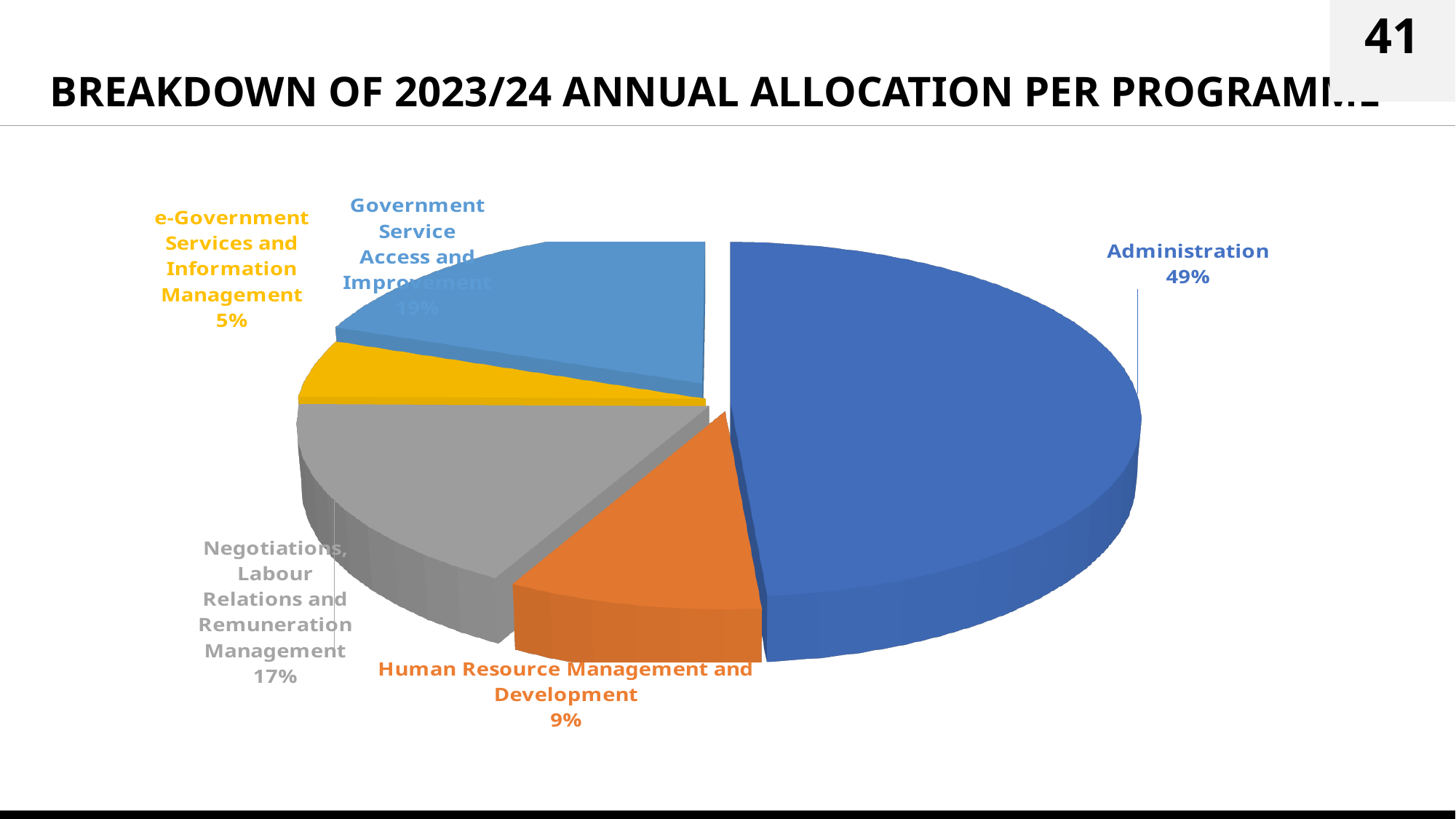
How many programmes are shown in the pie chart? 5 What is the title of the chart on this slide? Breakdown of 2023/24 Annual Allocation per Programme Which has a larger share: Negotiations, Labour Relations and Remuneration Management or Human Resource Management and Development? Negotiations, Labour Relations and Remuneration Management What percentage is shown for e-Government Services and Information Management? 5% What percentage is shown for Human Resource Management and Development? 9% What type of chart is used on this slide? Pie chart What share of the 2023/24 annual allocation goes to Administration? 49% What percentage is shown for Negotiations, Labour Relations and Remuneration Management? 17% Which programme receives the smallest share of the allocation? e-Government Services and Information Management Which programme receives the largest share of the allocation? Administration What is the difference in percentage points between Administration and Government Service Access and Improvement? 30 What percentage is shown for Government Service Access and Improvement? 19%